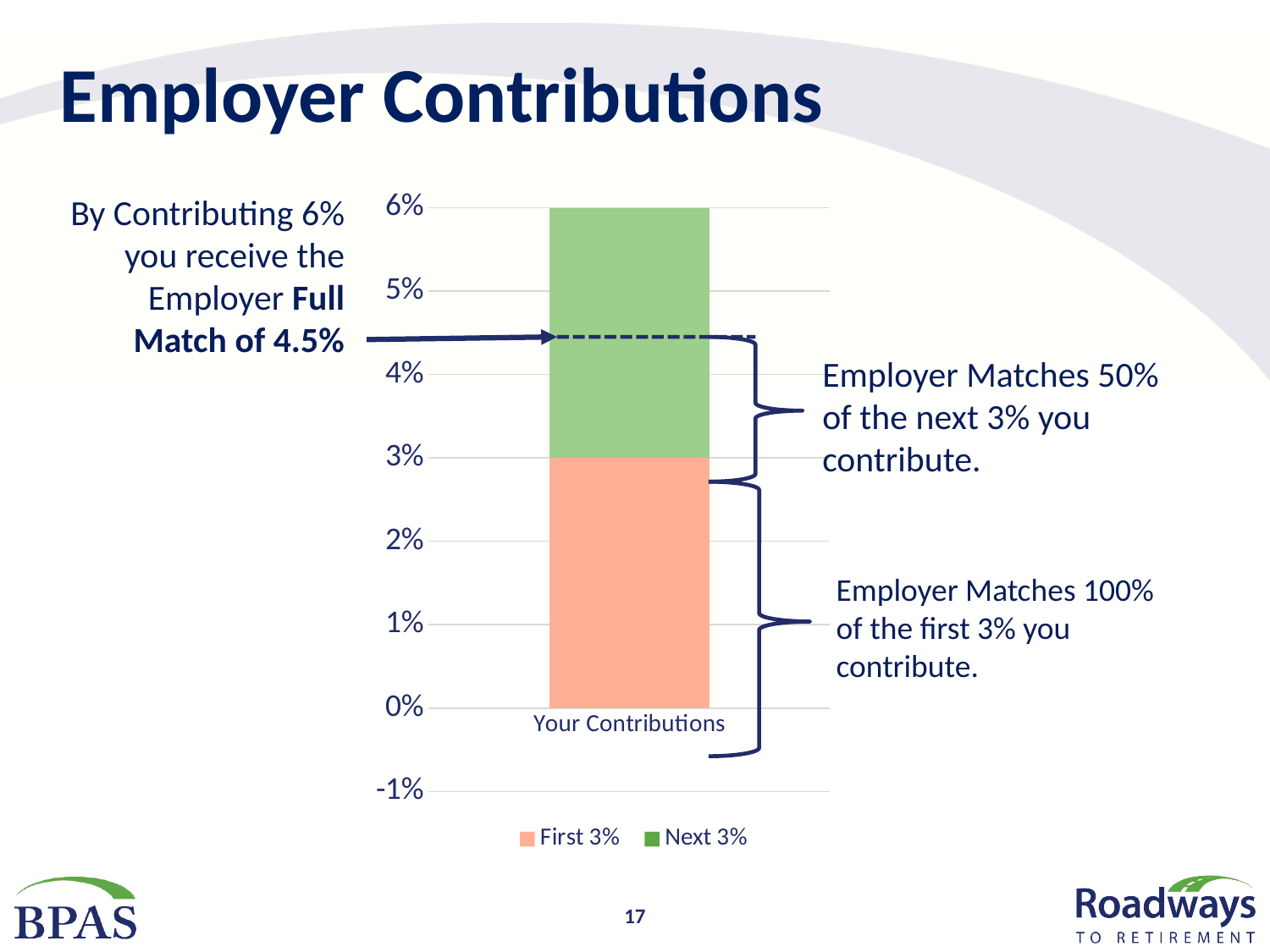
Is the total of the stacked bar for Your Contributions greater or less than 5%? greater How many series does the chart legend list? 2 How many categories are plotted on the x axis of the chart? 1 Is the First 3% segment for Your Contributions greater or less than 4%? less What value does the First 3% segment reach for Your Contributions? 3% What is the label of the category on the x axis? Your Contributions What are the two series listed in the chart legend? First 3% and Next 3% What is the total height of the stacked bar for Your Contributions? 6% What kind of chart is shown on the slide? bar chart What is the highest value shown on the chart's vertical axis? 6%